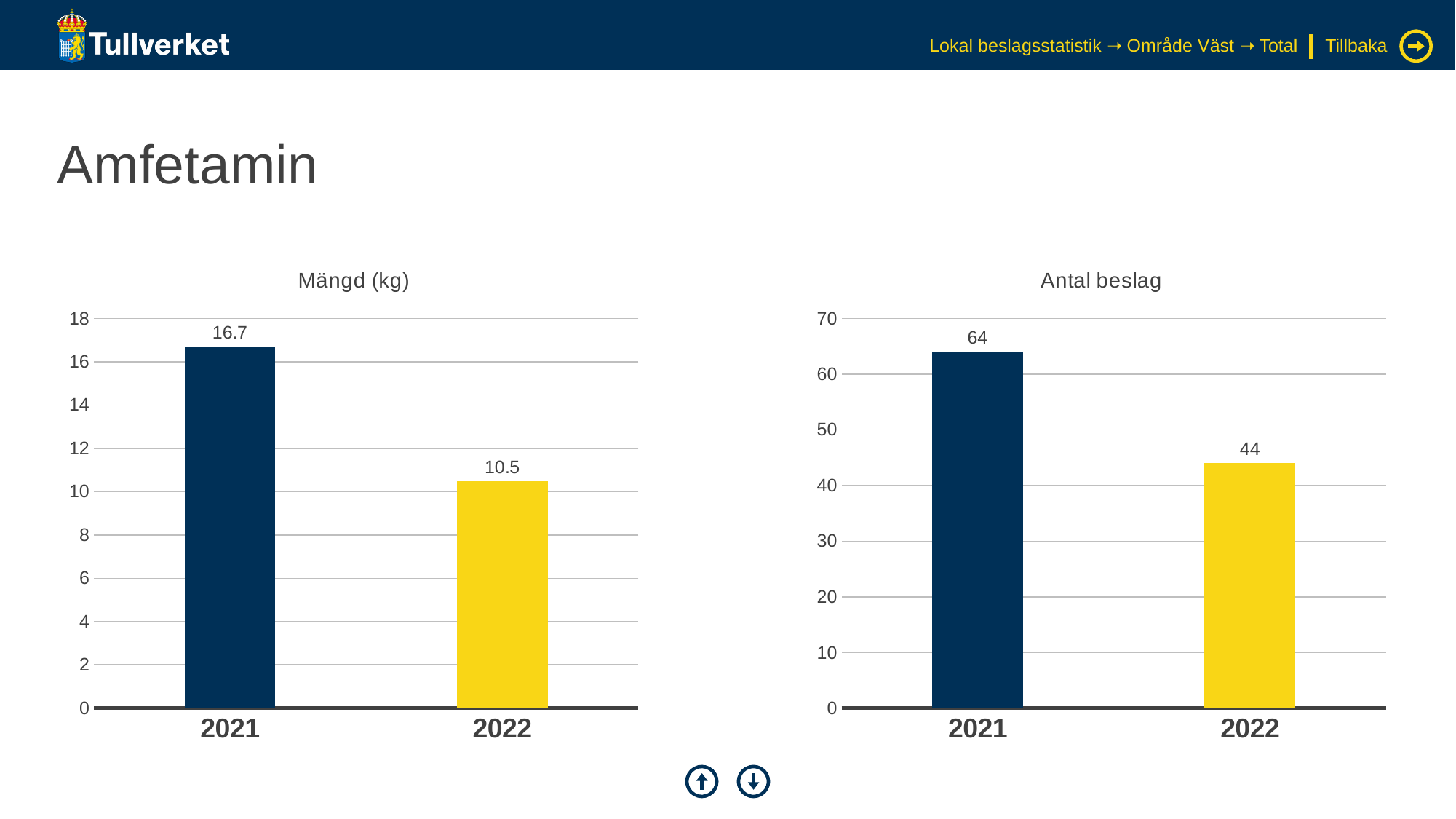
In the 'Antal beslag' chart, what is the value for 2022? 44 In the 'Antal beslag' chart, which year has the lowest value? 2022 In the 'Mängd (kg)' chart, how many years are shown on the x axis? 2 In the 'Antal beslag' chart, what is the difference between the 2021 and 2022 values? 20 In the 'Mängd (kg)' chart, what is the value for 2022? 10.5 In the 'Mängd (kg)' chart, what is the difference between the 2021 and 2022 values? 6.2 In the 'Mängd (kg)' chart, what is the value for 2021? 16.7 What kind of chart is the 'Antal beslag' chart? bar chart In the 'Mängd (kg)' chart, do the values rise or fall from 2021 to 2022? fall In the 'Antal beslag' chart, is the value for 2021 greater or less than 60? greater In the 'Antal beslag' chart, what is the value for 2021? 64 In the 'Mängd (kg)' chart, which year has the highest value? 2021